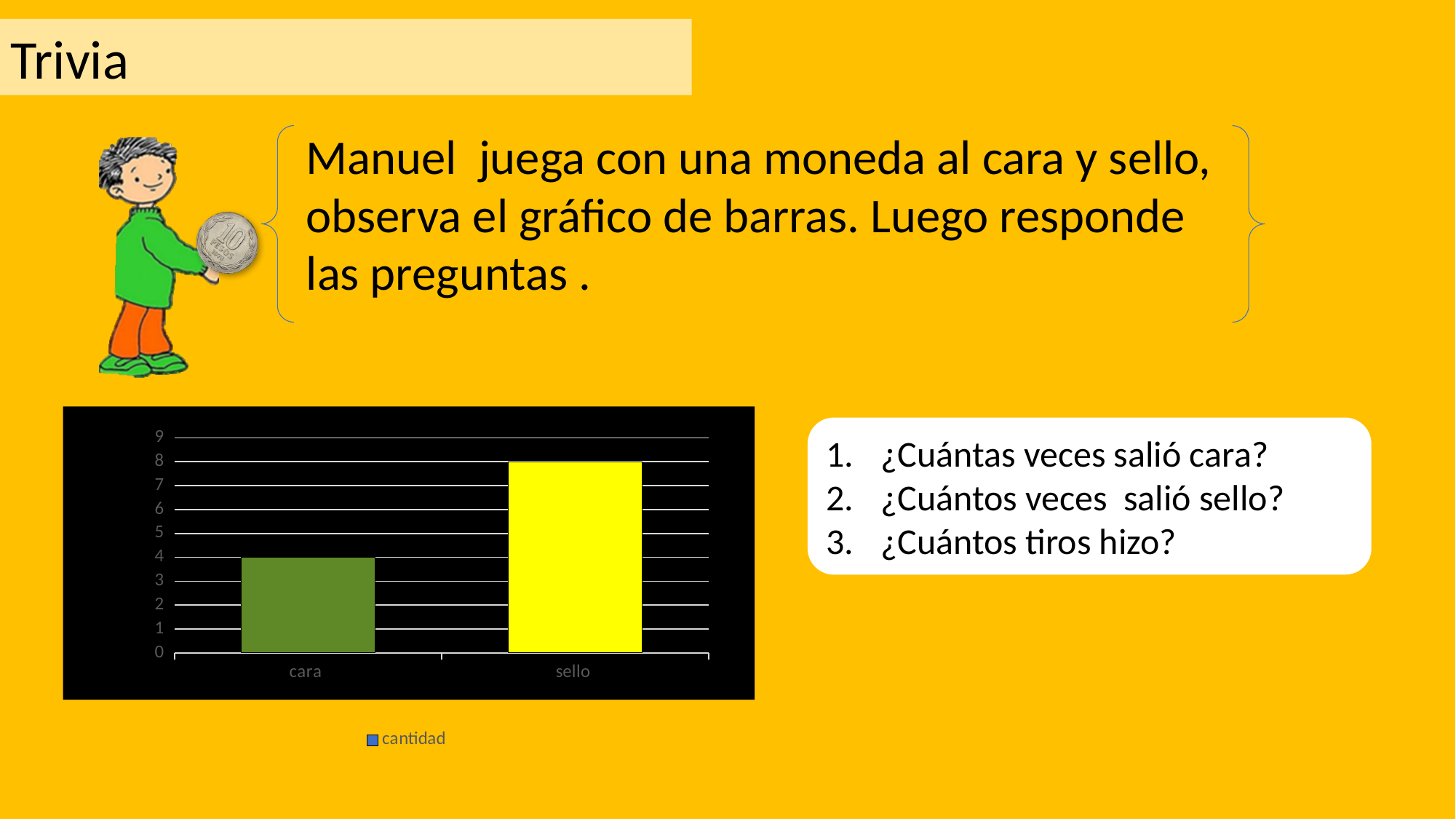
What is the value of the bar for sello? 8 Which is larger, the value for cara or the value for sello? sello Which category has the lowest bar? cara What is the difference between the value for sello and the value for cara? 4 What is the value of the bar for cara? 4 How many series does the legend list? 1 Is the value for sello greater or less than 5? greater Is the value for cara greater or less than 6? less Which category has the highest bar? sello How many categories are shown on the x axis of the chart? 2 What is the name of the series shown in the legend? cantidad What kind of chart is shown on the slide? bar chart